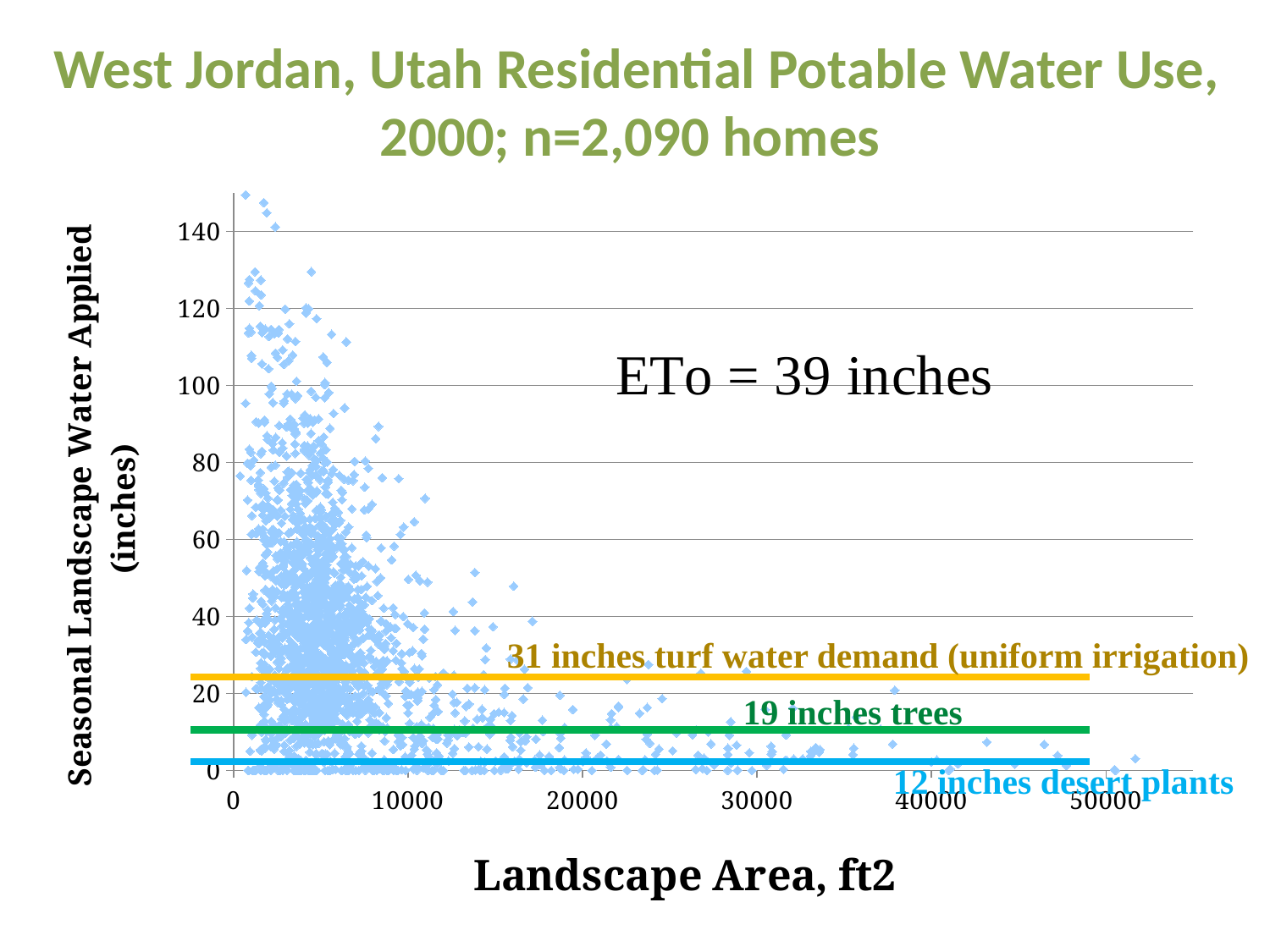
What kind of chart is shown on the slide? scatter plot What is the label of the x axis? Landscape Area, ft2 Which is larger, the water demand for trees or for desert plants? trees How many homes are included in the data set, according to the chart title? 2,090 What is the difference between ETo and the turf water demand? 8 inches What is the turf water demand (uniform irrigation) shown by the reference line? 31 inches Of the three labelled reference lines (turf, trees, desert plants), which has the highest water demand? turf water demand (31 inches) What is the difference between the turf water demand and the trees water demand? 12 inches What water demand value is labelled for trees? 19 inches What water demand value is labelled for desert plants? 12 inches What is the ETo value annotated on the chart? 39 inches Is the highest plotted value of seasonal landscape water applied greater or less than 140? greater